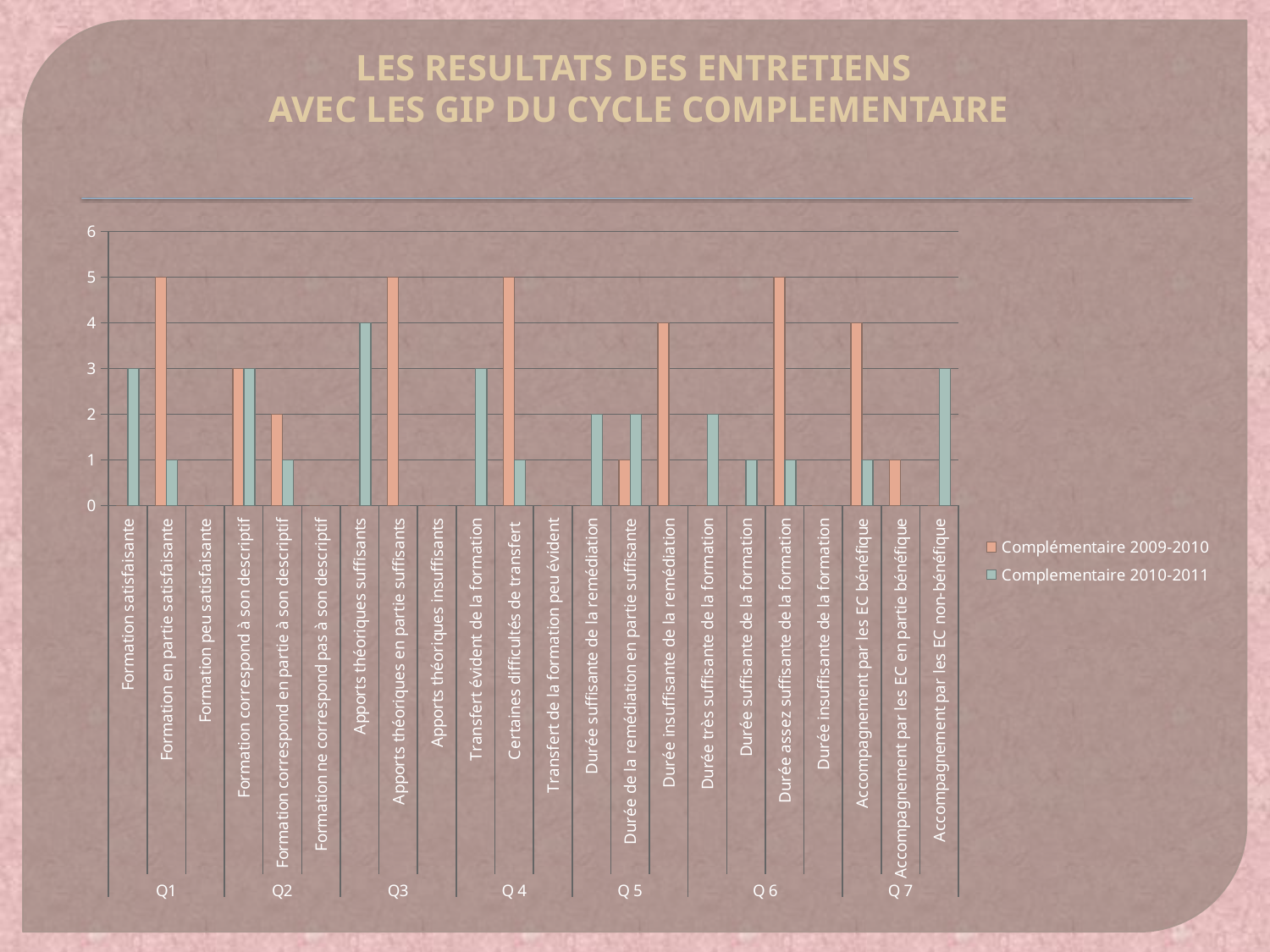
Which series has the larger value for "Formation satisfaisante", Complémentaire 2009-2010 or Complementaire 2010-2011? Complementaire 2010-2011 What is the value for "Formation en partie satisfaisante" in the Complémentaire 2009-2010 series? 5 What is the value for "Durée insuffisante de la remédiation" in the Complémentaire 2009-2010 series? 4 Which category in the Q7 group has the highest Complémentaire 2009-2010 value? Accompagnement par les EC bénéfique Is the value for "Durée assez suffisante de la formation" in the Complémentaire 2009-2010 series greater or less than 3? greater How many series does the legend list? 2 What kind of chart is shown on the slide? bar chart What colour are the bars for the Complémentaire 2009-2010 series? orange What is the value for "Accompagnement par les EC non-bénéfique" in the Complementaire 2010-2011 series? 3 What is the value for "Apports théoriques suffisants" in the Complementaire 2010-2011 series? 4 What is the difference between the Complémentaire 2009-2010 and Complementaire 2010-2011 values for "Certaines difficultés de transfert"? 4 How many categories are plotted along the x axis of the chart? 22